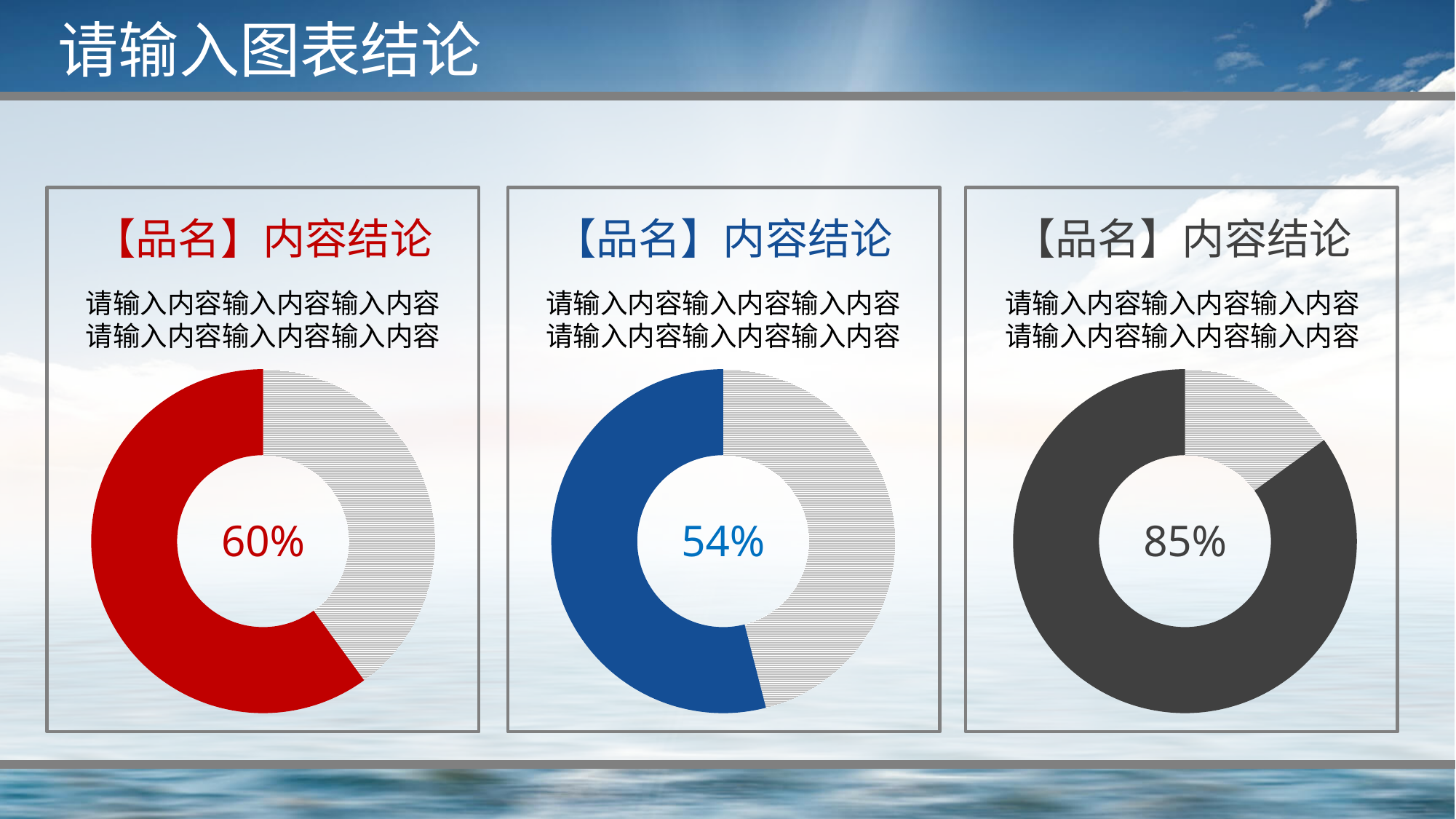
Which of the three donut charts on the slide shows the lowest percentage: left, middle or right? middle What percentage is shown in the centre of the left donut chart? 60% Which of the three donut charts on the slide shows the highest percentage: left, middle or right? right What is the difference between the percentage in the left donut chart and the percentage in the middle donut chart? 6% How many donut charts are shown on the slide? 3 What colour is the filled portion of the left donut chart? red What colour is the filled portion of the middle donut chart? blue What percentage is shown in the centre of the middle donut chart? 54% What kind of chart is used in each of the three panels on the slide? donut chart What percentage is shown in the centre of the right donut chart? 85% What is the difference between the percentage in the right donut chart and the percentage in the left donut chart? 25% Is the percentage in the left donut chart larger or smaller than the percentage in the middle donut chart? larger